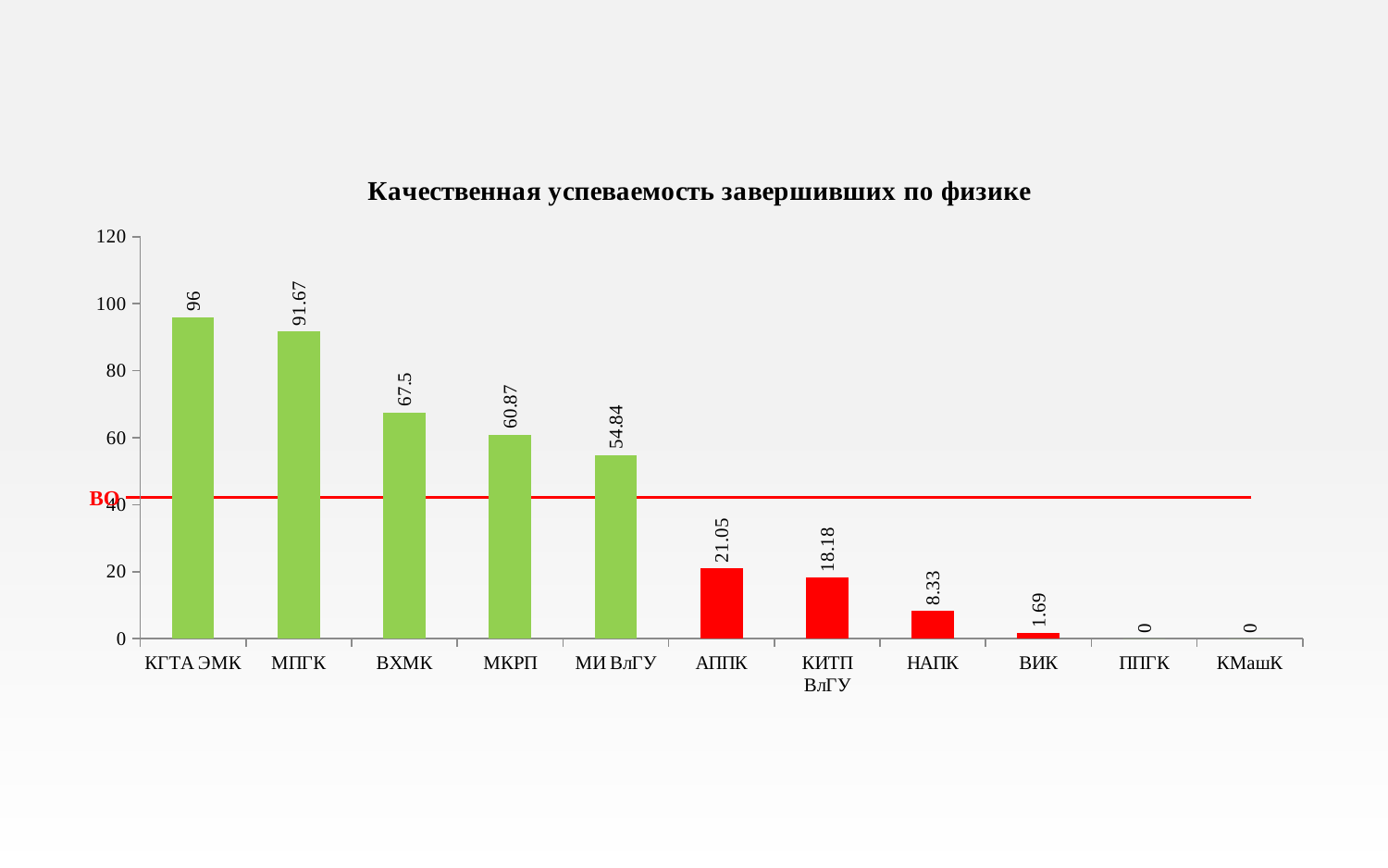
What is the value for МКРП? 60.87 What is the title of the chart? Качественная успеваемость завершивших по физике What is the value for КГТА ЭМК? 96 What is the value for КИТП ВлГУ? 18.18 What is the difference between the values for МПГК and ВХМК? 24.17 What is the value for ВИК? 1.69 How many categories are shown on the x axis? 11 What is the difference between the values for АППК and НАПК? 12.72 Which is larger, the value for МИ ВлГУ or the value for АППК? МИ ВлГУ Which category has the highest value? КГТА ЭМК Is the value for ВХМК greater or less than 60? greater What kind of chart is shown on the slide? bar chart